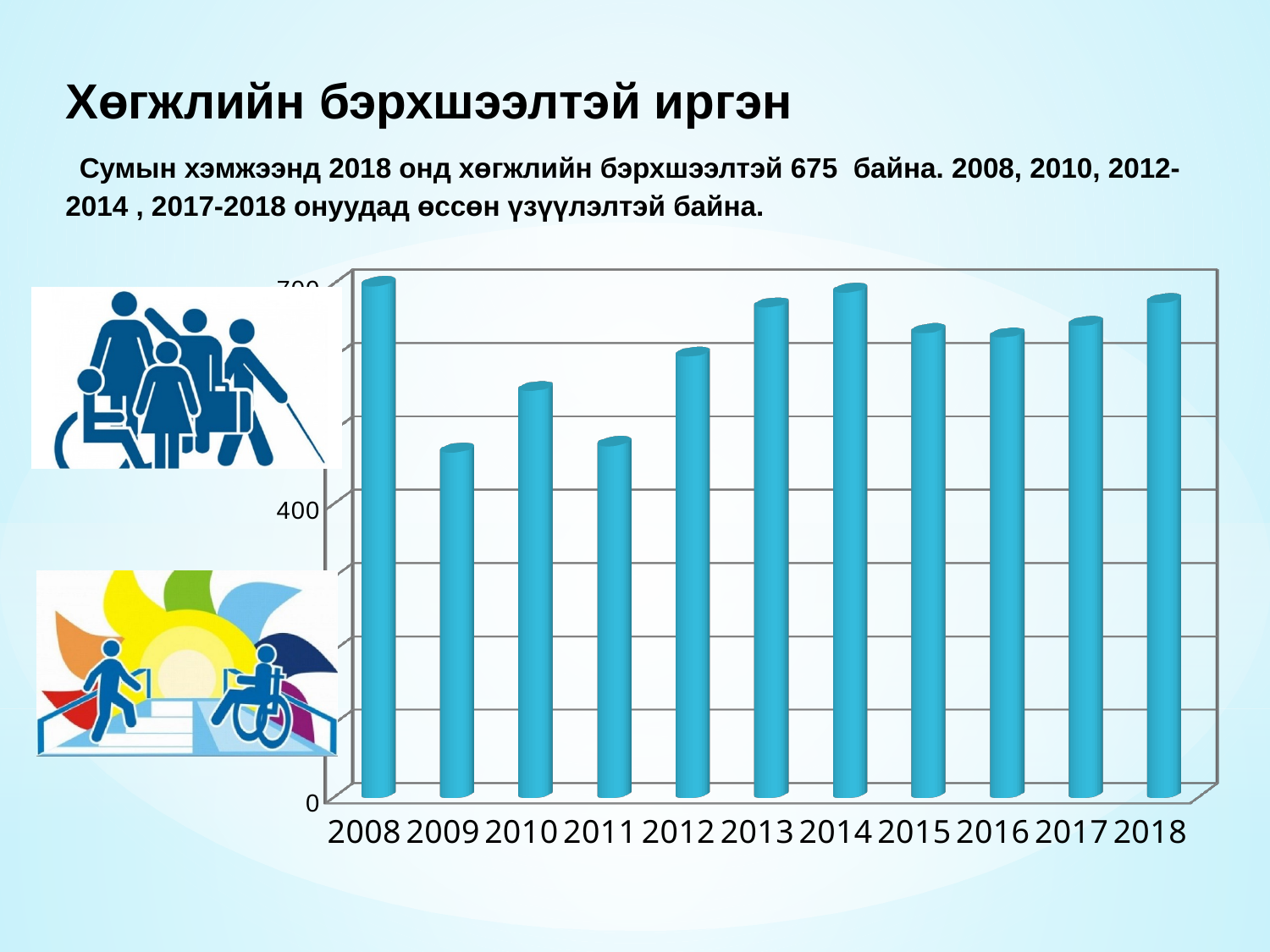
How many years are shown on the x axis of the chart? 11 Which year is the last category on the x axis of the chart? 2018 What kind of chart is shown on the slide? bar chart Which is larger, the value for 2008 or the value for 2009? 2008 Which year is the first category on the x axis of the chart? 2008 Is the value for 2009 greater or less than 400? greater Which is larger, the value for 2013 or the value for 2012? 2013 Do the values rise or fall from 2014 to 2016? fall Is the value for 2009 greater or less than 700? less Do the values rise or fall from 2009 to 2010? rise Which is larger, the value for 2010 or the value for 2011? 2010 Is the value for 2015 greater or less than 400? greater